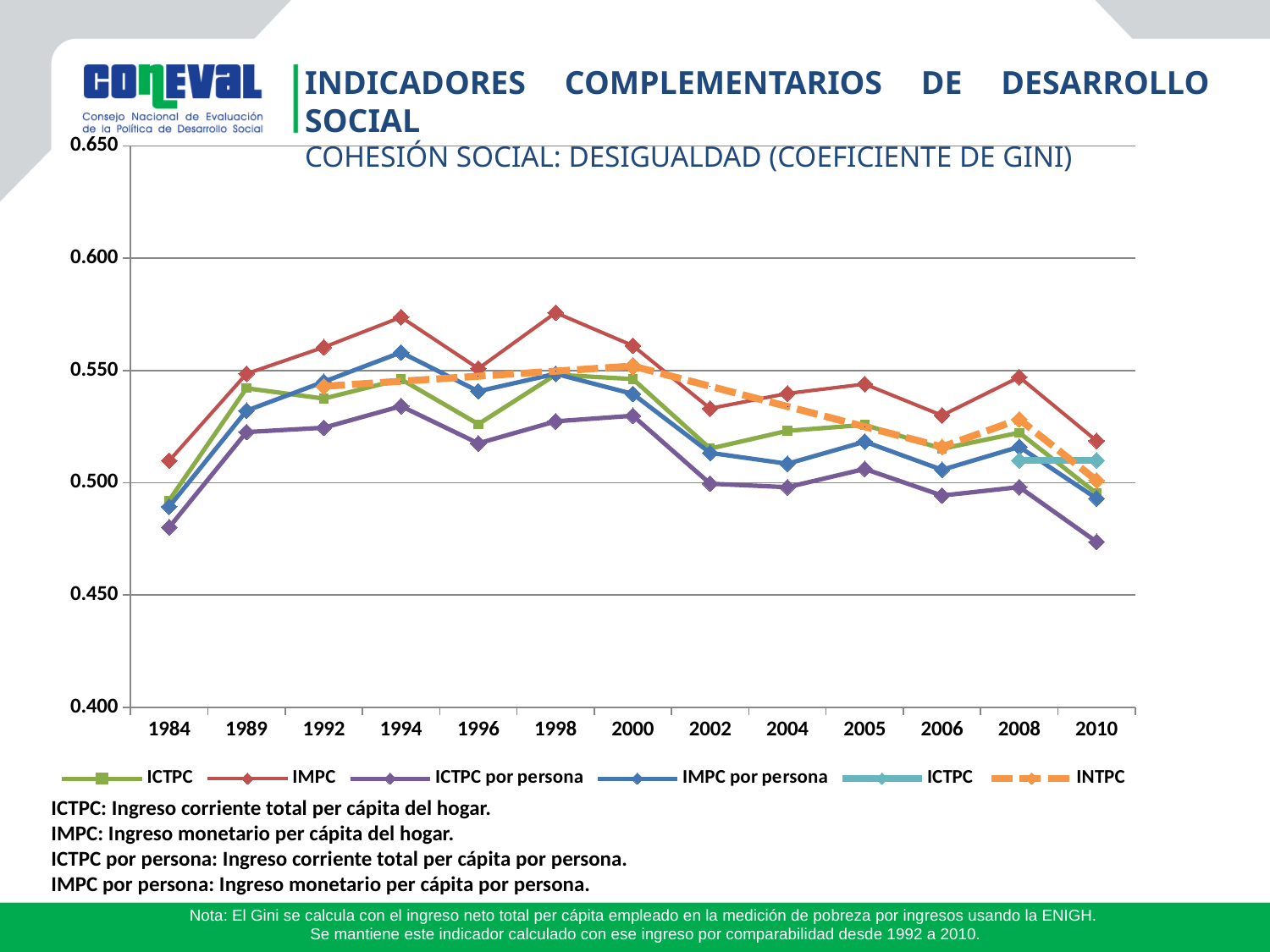
Is the value for ICTPC por persona in 2010 greater or less than 0.500? less What is the title of the chart? COHESIÓN SOCIAL: DESIGUALDAD (COEFICIENTE DE GINI) Which series is drawn as a dashed orange line? INTPC Does the IMPC series rise or fall from 2008 to 2010? fall Is the value for ICTPC por persona in 1984 greater or less than 0.500? less In 1994, which is larger: IMPC or ICTPC por persona? IMPC Is the value for IMPC in 2010 greater or less than 0.500? greater What kind of chart is shown on the slide? line chart How many years are plotted along the x axis of the chart? 13 Which series has the lowest value in 2010? ICTPC por persona How many series does the chart legend list? 6